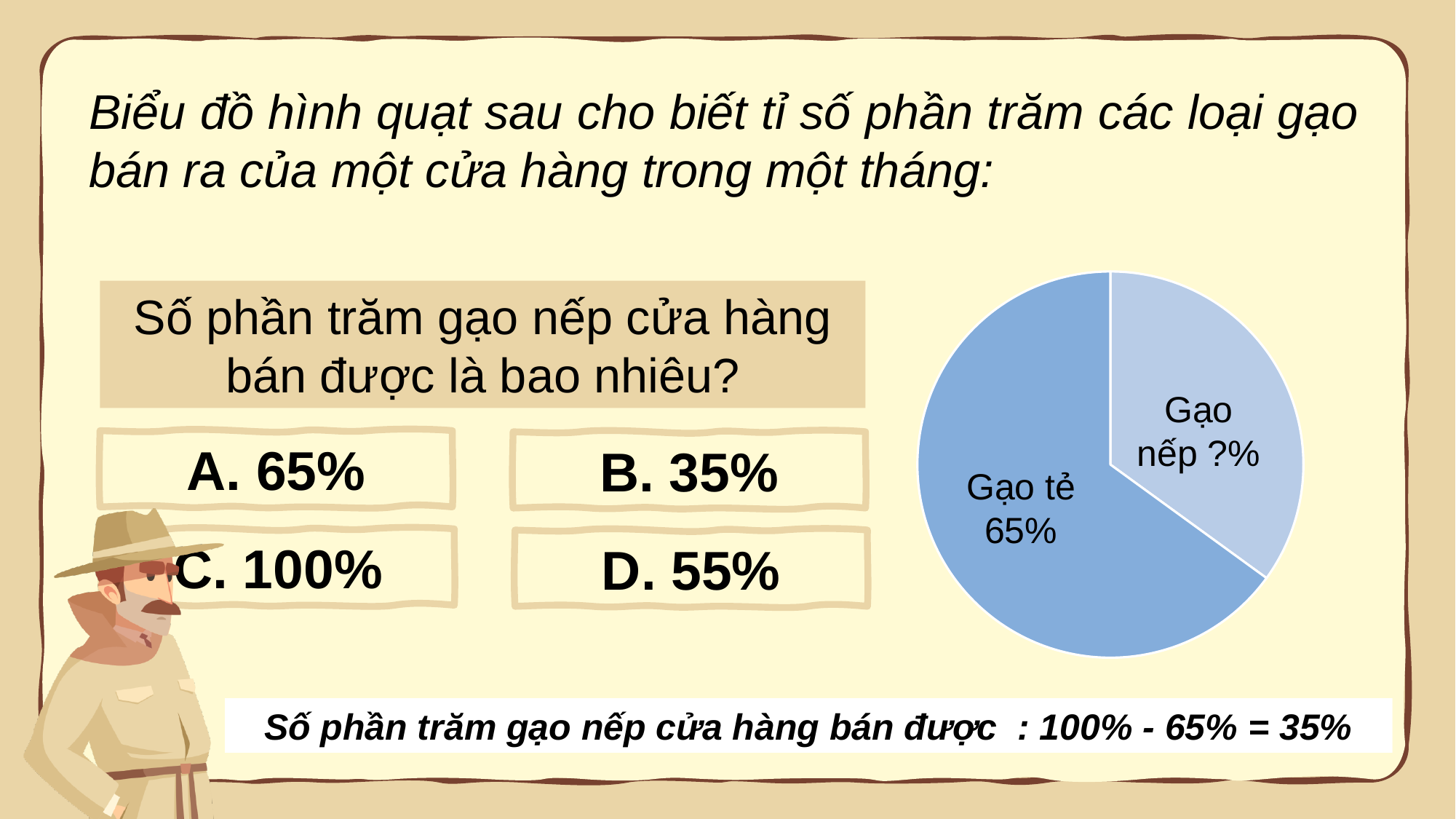
What share of the pie does Gạo nếp represent, according to the solution on the slide? 35% Is the share for Gạo tẻ greater or less than 50%? greater What label is printed on the lighter blue slice of the pie chart? Gạo nếp ?% Which slice of the pie chart is the largest? Gạo tẻ Which slice of the pie chart is the smallest? Gạo nếp What percentage is shown for Gạo tẻ in the pie chart? 65% Which slice of the pie chart is drawn in the darker blue colour? Gạo tẻ What kind of chart is shown on the slide? pie chart How many slices does the pie chart have? 2 Which is larger in the pie chart, Gạo tẻ or Gạo nếp? Gạo tẻ What is the difference between the Gạo tẻ share and the Gạo nếp share, using the values printed on the slide? 30%